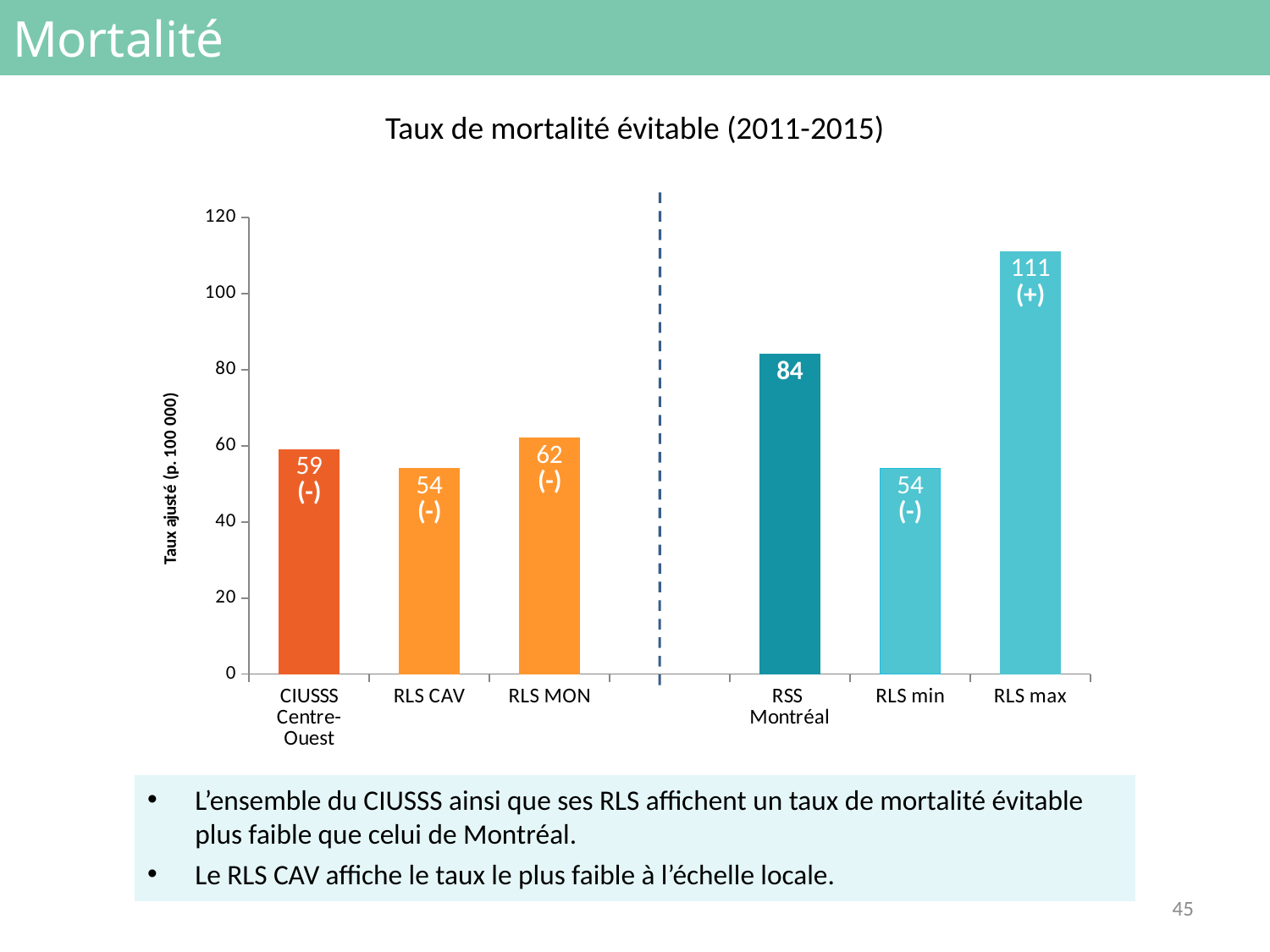
Which category has the highest value? RLS max What is the value for RLS MON? 62 What is the value for RSS Montréal? 84 How many bars are shown in the chart? 6 What kind of chart is shown on the slide? bar chart What is the difference between the values for RSS Montréal and CIUSSS Centre-Ouest? 25 What is the value for CIUSSS Centre-Ouest? 59 What is the title of the chart? Taux de mortalité évitable (2011-2015) What is the difference between the values for RLS max and RLS min? 57 Which is larger, the value for RLS MON or the value for RLS CAV? RLS MON What is the value for RLS max? 111 Is the value for RSS Montréal greater or less than 100? less